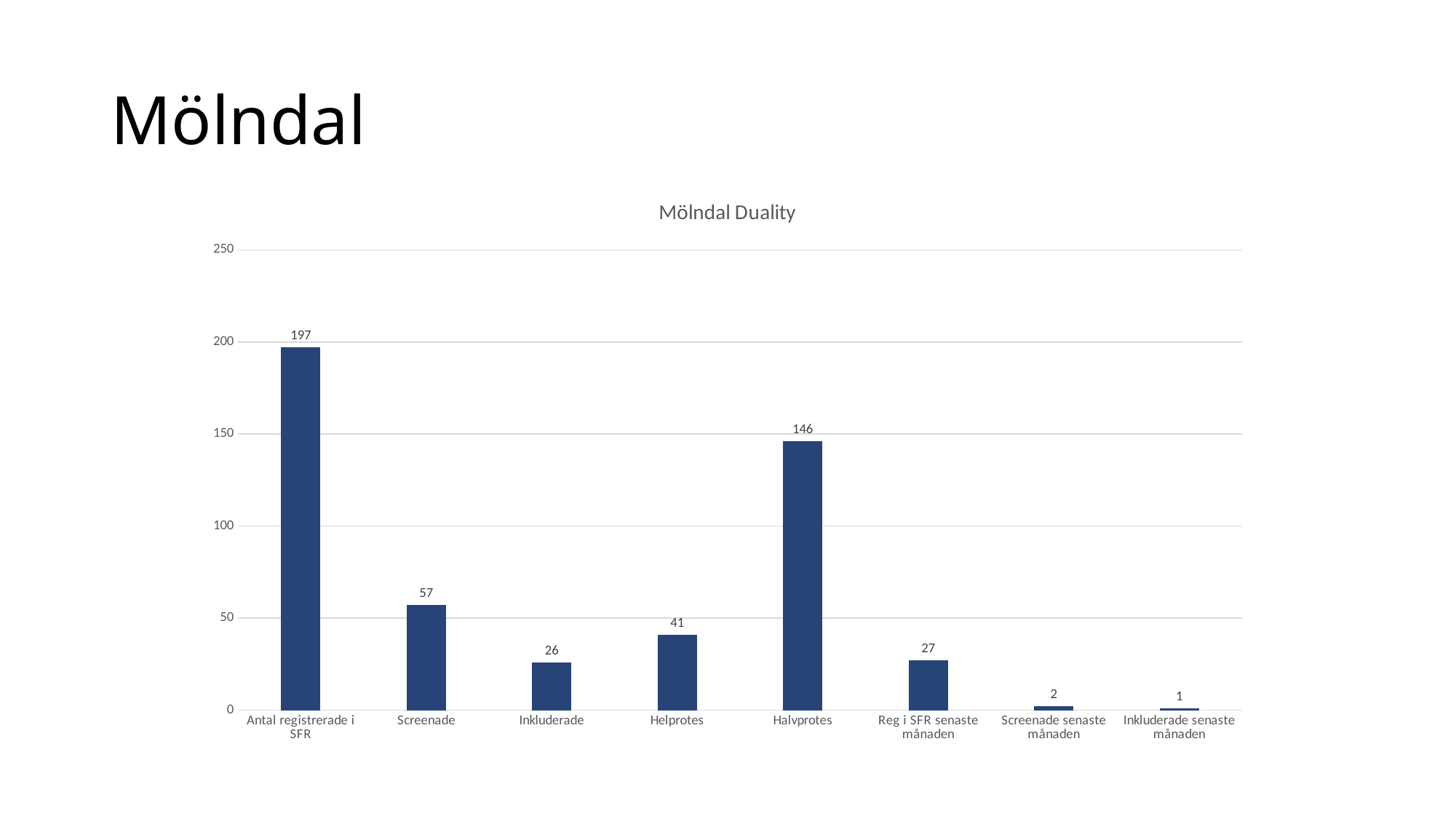
What is the difference between the values for Screenade and Inkluderade? 31 What is the difference between the values for Halvprotes and Helprotes? 105 What is the value for Halvprotes? 146 What is the value for Reg i SFR senaste månaden? 27 Which category has the lowest value? Inkluderade senaste månaden Is the value for Screenade greater or less than 50? greater What is the value for Antal registrerade i SFR? 197 What kind of chart is shown on the slide? Bar chart Which category has the highest value? Antal registrerade i SFR How many categories are shown on the x axis? 8 Which is larger, the value for Helprotes or the value for Reg i SFR senaste månaden? Helprotes What is the title of the chart? Mölndal Duality